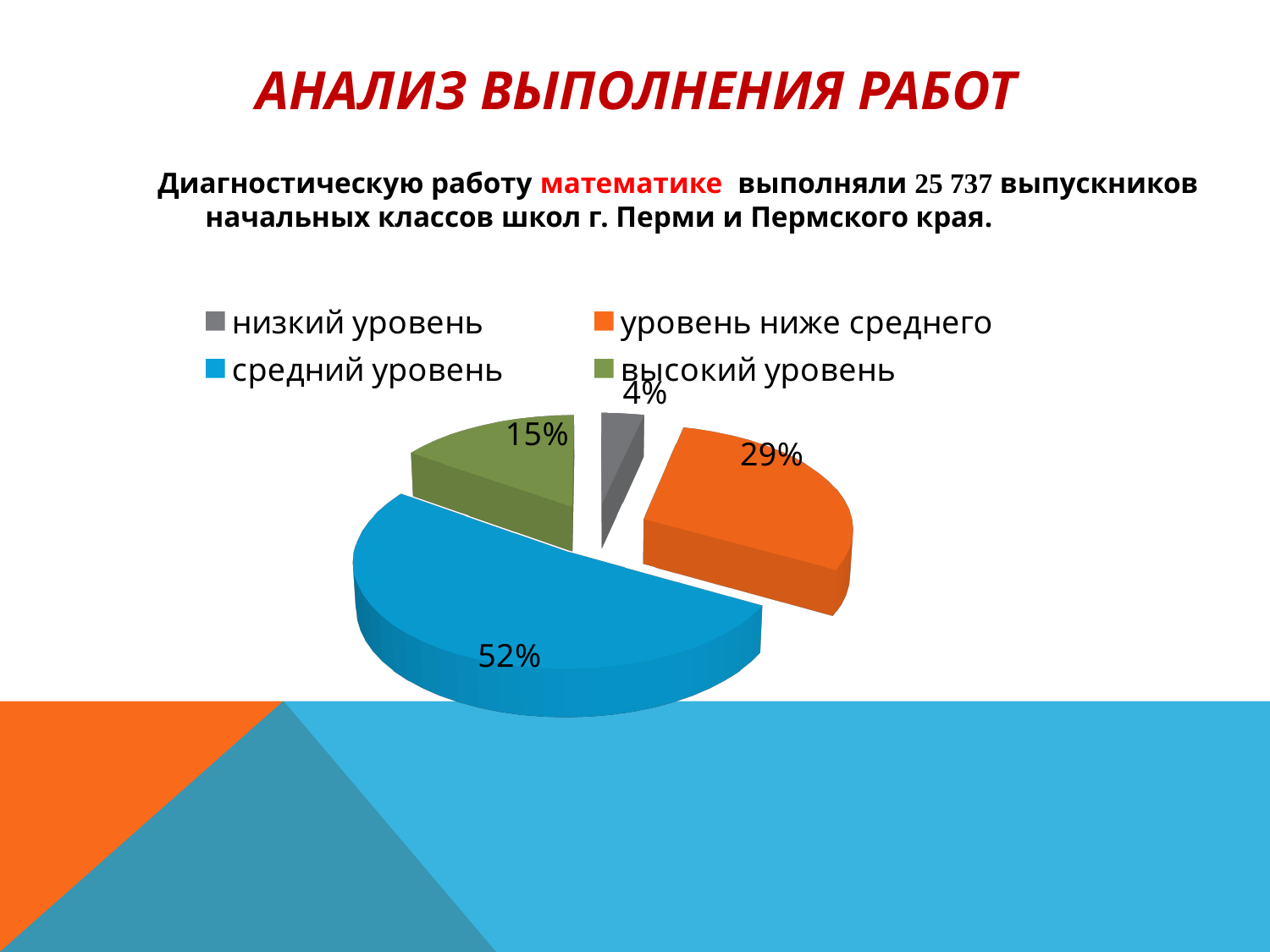
What is the difference between the shares of "средний уровень" and "уровень ниже среднего"? 23% What kind of chart is shown on the slide? pie chart What is the difference between the shares of "высокий уровень" and "низкий уровень"? 11% Which category has the smallest slice of the pie? низкий уровень Which is larger: the share of "уровень ниже среднего" or the share of "высокий уровень"? уровень ниже среднего What share of the pie does "уровень ниже среднего" have? 29% How many categories does the legend list? 4 What colour is the slice for "высокий уровень"? green Which category has the largest slice of the pie? средний уровень What share of the pie does "высокий уровень" have? 15% What share of the pie does "средний уровень" have? 52%